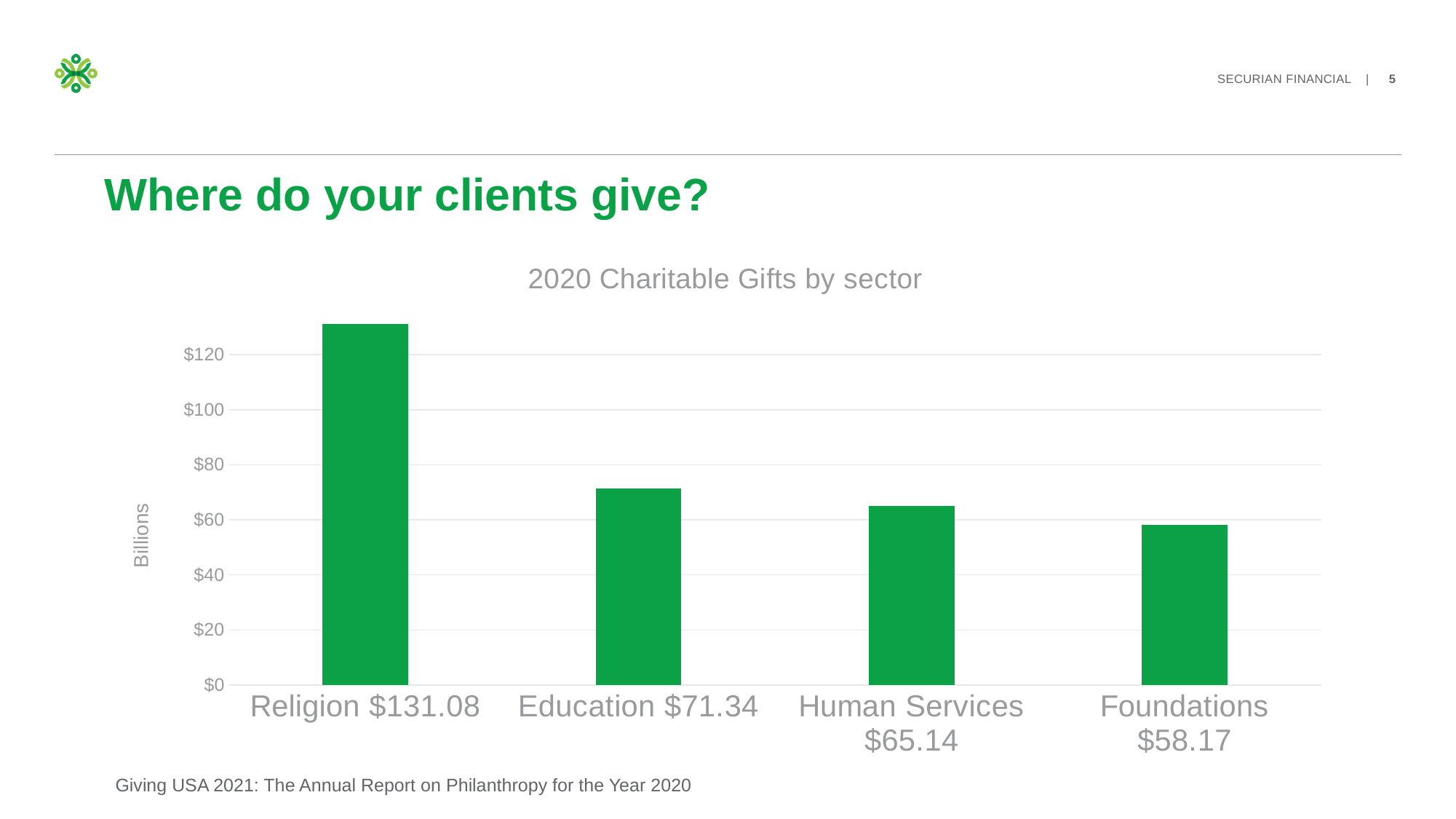
What is the value for Religion in the 2020 Charitable Gifts by sector chart? $131.08 What is the difference between the values for Human Services and Foundations? $6.97 What is the difference between the values for Religion and Education? $59.74 What is the value for Human Services in the chart? $65.14 What is the value for Foundations in the chart? $58.17 Which sector has the lowest value in the chart? Foundations What is the value for Education in the chart? $71.34 Which sector has the highest value in the chart? Religion What is the label on the vertical axis of the chart? Billions Which is larger, the value for Education or the value for Human Services? Education How many sectors are shown in the chart? 4 What kind of chart is shown on the slide? Bar chart